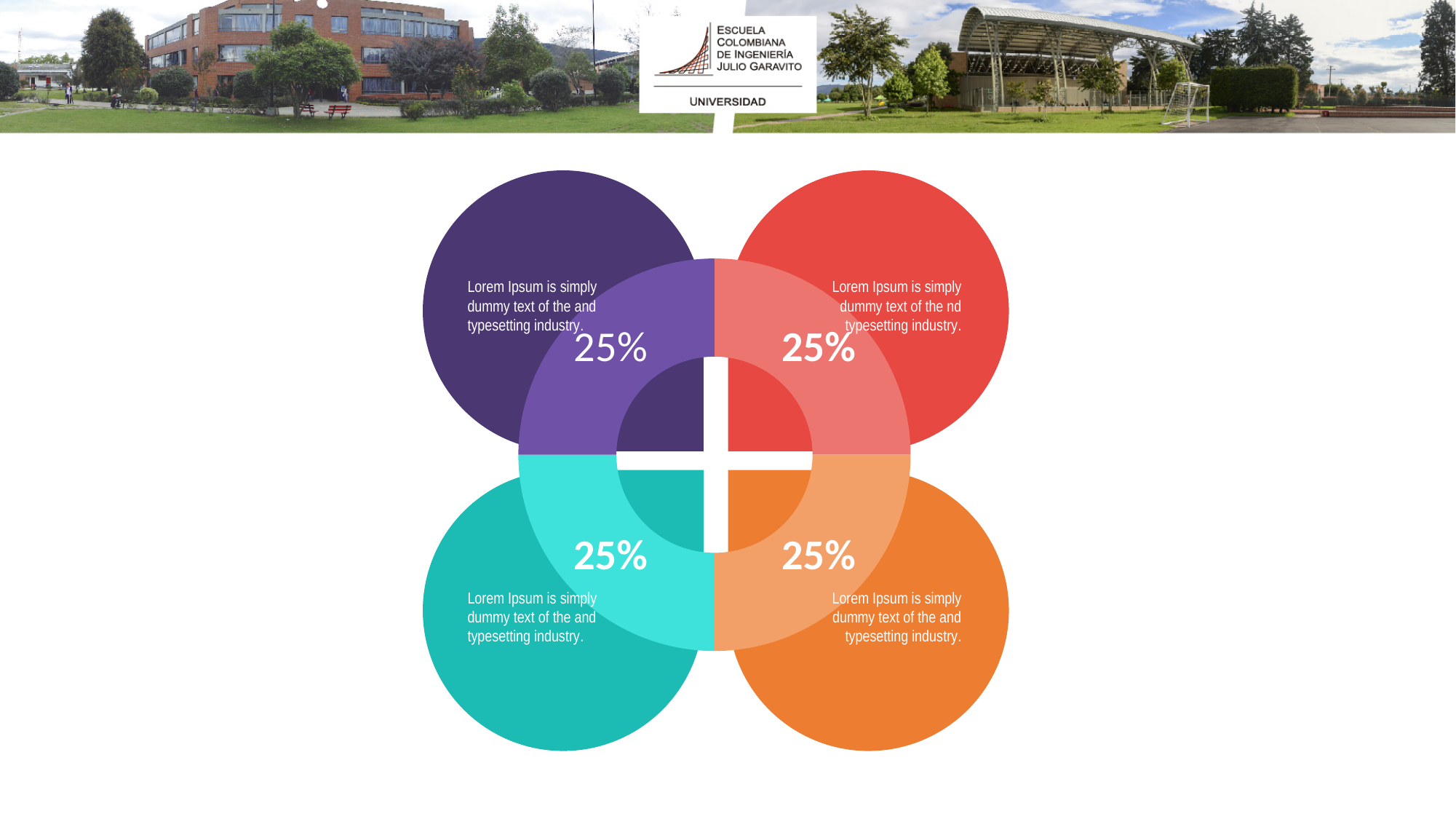
What is the combined share of the purple and red segments of the donut chart? 50% Which four colours are used for the segments of the donut chart? Purple, red, teal and orange What percentage is shown on the purple (top-left) segment of the donut chart? 25% Is the value of the purple segment greater or less than 50%? less What percentage is shown on the teal (bottom-left) segment of the donut chart? 25% What is the total of all four segment percentages in the donut chart? 100% How many segments does the donut chart have? 4 What percentage is shown on the orange (bottom-right) segment of the donut chart? 25% What is the difference between the teal segment's value and the orange segment's value? 0% Are all four segments of the donut chart the same size? Yes What percentage is shown on the red (top-right) segment of the donut chart? 25% What kind of chart is shown in the centre of the slide? Pie chart (donut)